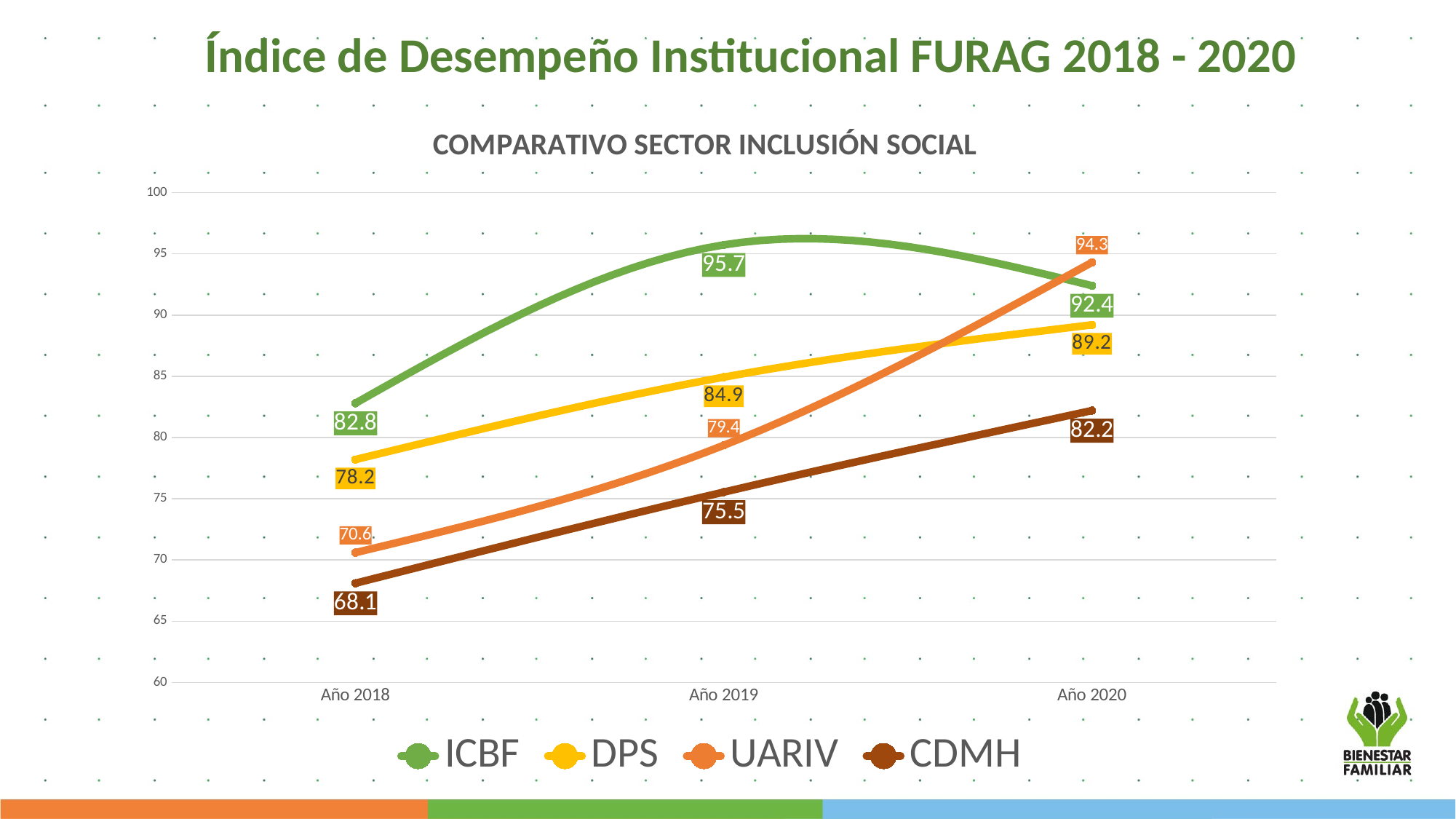
What is the value for UARIV in Año 2020? 94.3 What is the value for DPS in Año 2019? 84.9 What is the difference between the ICBF values for Año 2019 and Año 2020? 3.3 Which series has the lowest value in Año 2018? CDMH Do the values for DPS rise or fall from Año 2018 to Año 2020? Rise Which series has the highest value in Año 2020? UARIV Which is larger in Año 2019: the value for UARIV or the value for CDMH? UARIV What is the value for ICBF in Año 2019? 95.7 What kind of chart is shown on the slide? Line chart What is the value for CDMH in Año 2018? 68.1 What is the title of the chart? COMPARATIVO SECTOR INCLUSIÓN SOCIAL How many series does the legend list? 4